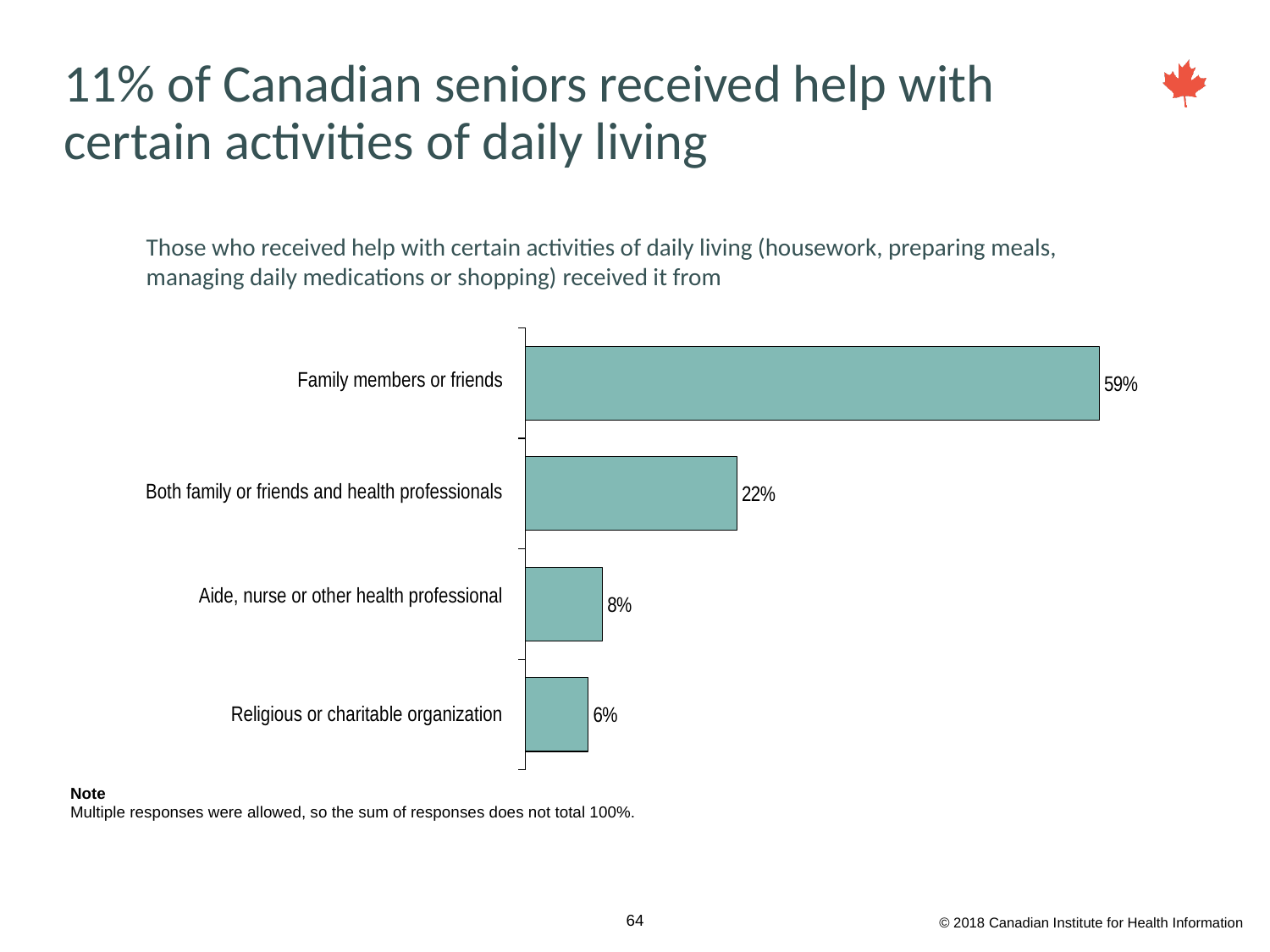
How many categories are shown in the chart? 4 What kind of chart is shown on the slide? Bar chart Which source of help has the lowest percentage? Religious or charitable organization What is the value for 'Religious or charitable organization'? 6% Which is larger: the value for 'Both family or friends and health professionals' or the value for 'Aide, nurse or other health professional'? Both family or friends and health professionals According to the note, why does the sum of responses not total 100%? Multiple responses were allowed Which source of help has the highest percentage? Family members or friends What is the difference in percentage points between 'Family members or friends' and 'Both family or friends and health professionals'? 37 What is the difference in percentage points between 'Aide, nurse or other health professional' and 'Religious or charitable organization'? 2 What percentage received help from an aide, nurse or other health professional? 8% What percentage of seniors received help with activities of daily living from family members or friends? 59% What is the value for 'Both family or friends and health professionals'? 22%